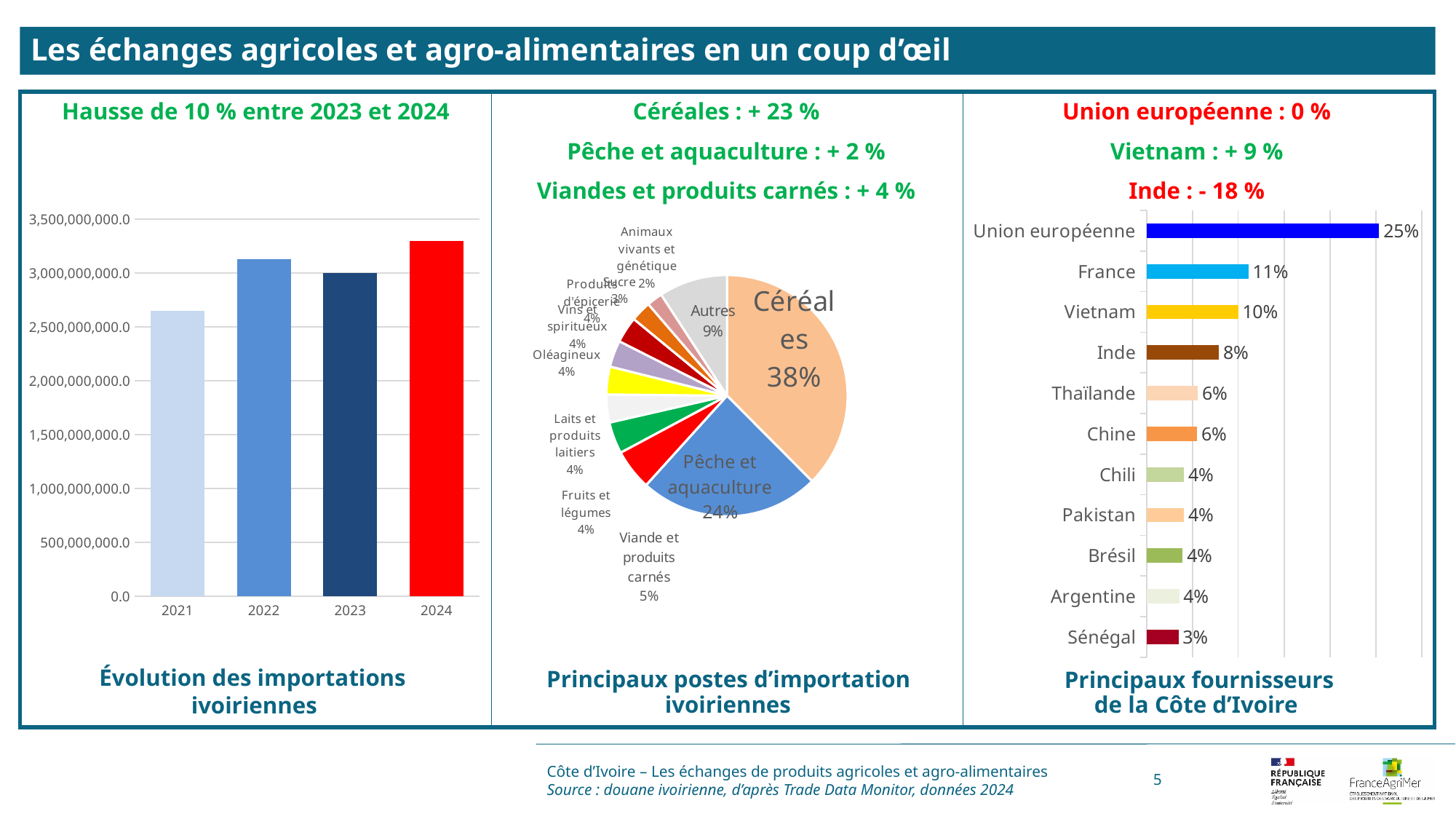
What kind of chart is 'Principaux postes d'importation ivoiriennes'? Pie chart In the pie chart 'Principaux postes d'importation ivoiriennes', what share does 'Pêche et aquaculture' have? 24% How many suppliers are listed in the chart titled 'Principaux fournisseurs de la Côte d'Ivoire'? 11 In the chart titled 'Évolution des importations ivoiriennes', which year has the lowest bar? 2021 In the pie chart 'Principaux postes d'importation ivoiriennes', which slice is the largest? Céréales In the chart titled 'Principaux fournisseurs de la Côte d'Ivoire', what is the value for Vietnam? 10% In the chart titled 'Évolution des importations ivoiriennes', which year has the highest bar? 2024 How many years are shown in the chart titled 'Évolution des importations ivoiriennes'? 4 In the chart titled 'Évolution des importations ivoiriennes', which is larger, the value for 2022 or the value for 2023? 2022 In the chart titled 'Évolution des importations ivoiriennes', is the value for 2021 greater or less than 2,500,000,000.0? greater In the chart titled 'Principaux fournisseurs de la Côte d'Ivoire', what is the difference between the values for Union européenne and France? 14 percentage points In the chart titled 'Évolution des importations ivoiriennes', is the value for 2022 greater or less than 3,000,000,000.0? greater